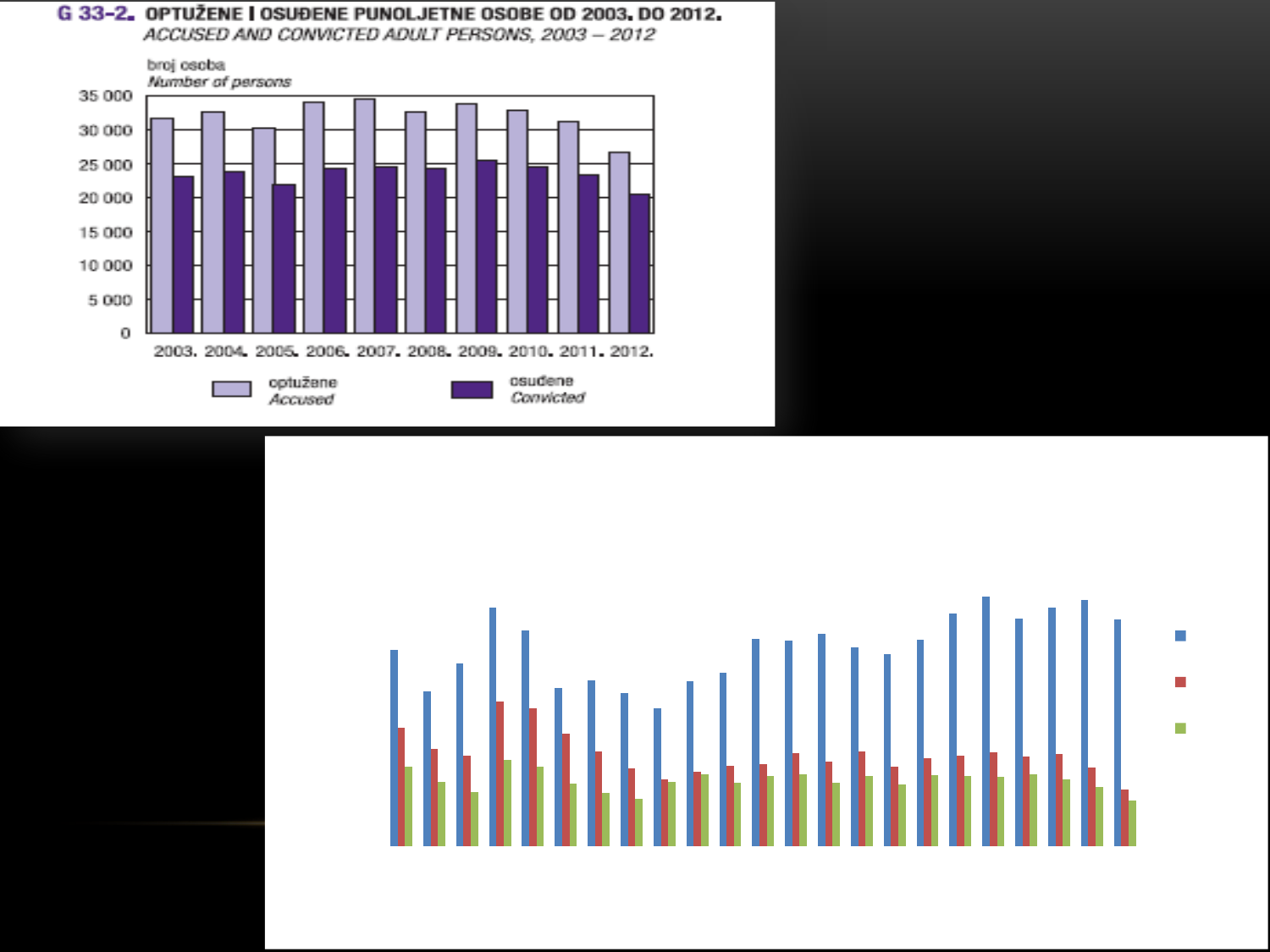
In the top chart (Accused and convicted adult persons, 2003–2012), what kind of chart is shown? bar chart In the top chart, which year has more accused persons, 2005 or 2006? 2006 In the top chart, is the number of convicted persons in 2005 greater or less than 25 000? less In the top chart, how many series does the legend list? 2 In the top chart, is the number of accused persons in 2007 greater or less than 30 000? greater In the top chart, how many years are shown on the x axis? 10 In the top chart, do the accused values rise or fall from 2009 to 2012? fall In the top chart, which year has the lowest number of accused persons? 2012 In the top chart, what are the two legend entries in English? Accused and Convicted In the bottom chart, how many series are shown? 3 In the top chart, is the number of accused persons in 2012 greater or less than 30 000? less In the top chart, which year has the lowest number of convicted persons? 2012